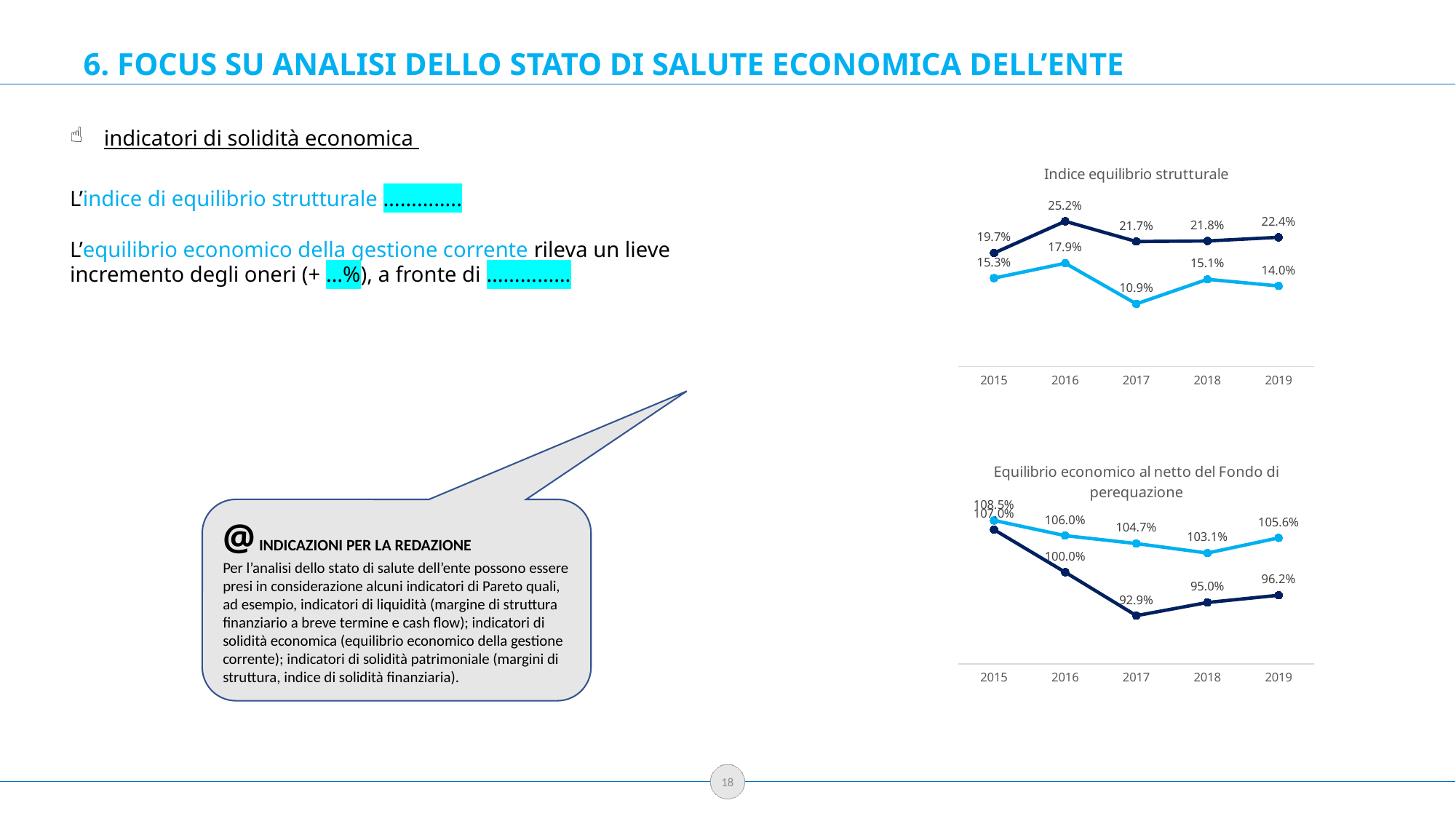
In the 'Equilibrio economico al netto del Fondo di perequazione' chart, what is the value of the light blue line in 2018? 103.1% In the 'Equilibrio economico al netto del Fondo di perequazione' chart, what is the value of the dark blue line in 2017? 92.9% In the 'Indice equilibrio strutturale' chart, what is the difference between the dark blue and light blue values in 2019? 8.4% How many line charts are shown on the slide? 2 In the 'Indice equilibrio strutturale' chart, in which year does the dark blue line reach its highest value? 2016 In the 'Equilibrio economico al netto del Fondo di perequazione' chart, which line has the higher value in 2019, the dark blue or the light blue? Light blue In the 'Equilibrio economico al netto del Fondo di perequazione' chart, does the light blue line rise or fall from 2015 to 2018? Fall How many years are shown on the x axis of the 'Indice equilibrio strutturale' chart? 5 In the 'Indice equilibrio strutturale' chart, in which year does the light blue line reach its lowest value? 2017 In the 'Indice equilibrio strutturale' chart, what is the value of the dark blue line in 2016? 25.2% In the 'Indice equilibrio strutturale' chart, what is the value of the light blue line in 2017? 10.9% What type of chart is 'Equilibrio economico al netto del Fondo di perequazione'? Line chart